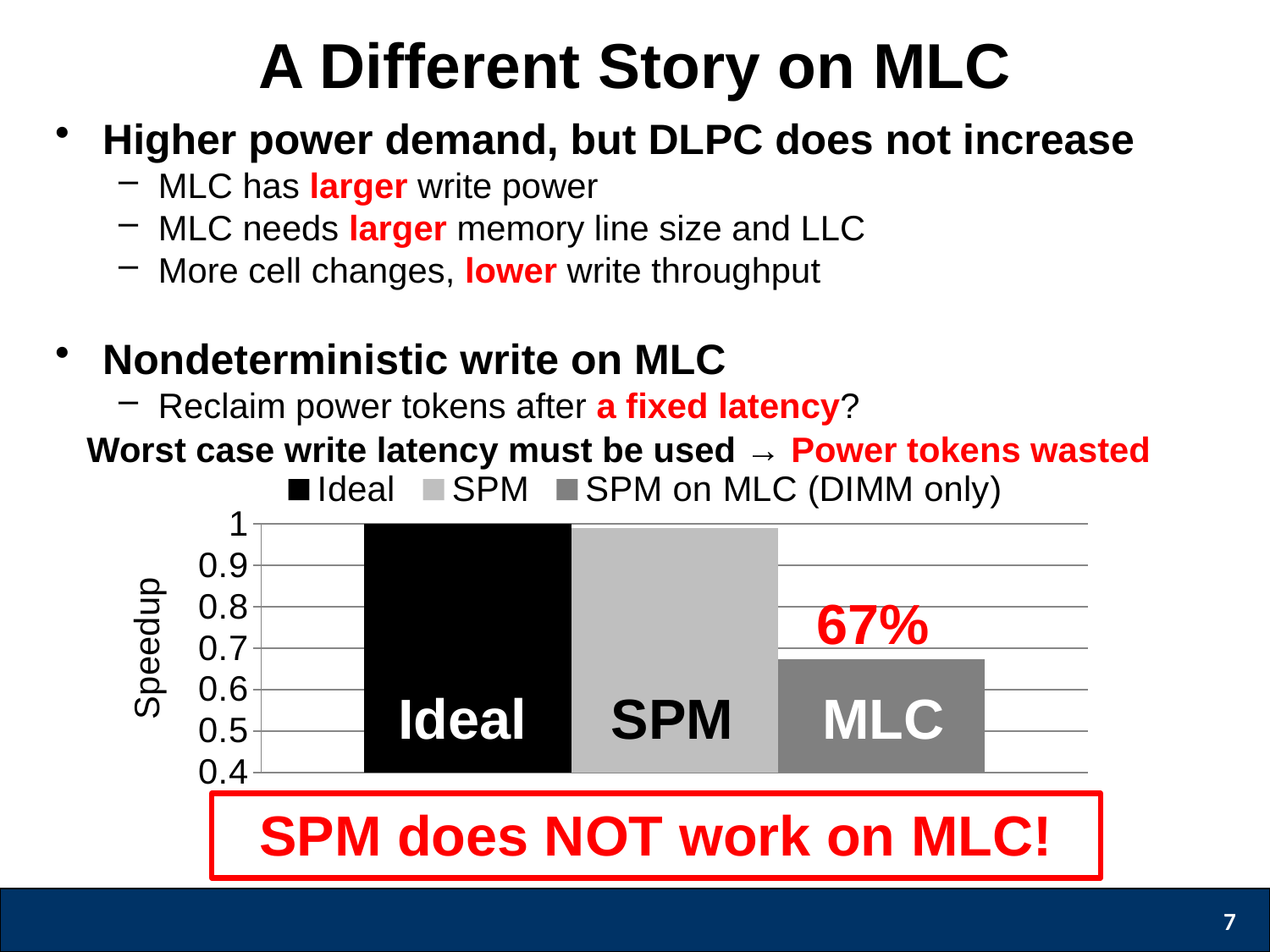
Which has the larger speedup, SPM or MLC? SPM What speedup does the Ideal bar reach on the y axis? 1 Which bar has the lowest speedup? MLC Do the bar values rise or fall from left to right across the chart? fall Is the speedup for MLC greater or less than 0.6? greater How many series does the chart legend list? 3 Is the speedup for SPM greater or less than 0.9? greater What is the label on the chart's y axis? Speedup What value is printed above the MLC bar? 67% What kind of chart is shown on the slide? bar chart How many bars are plotted in the chart? 3 Is the speedup for MLC greater or less than 0.7? less